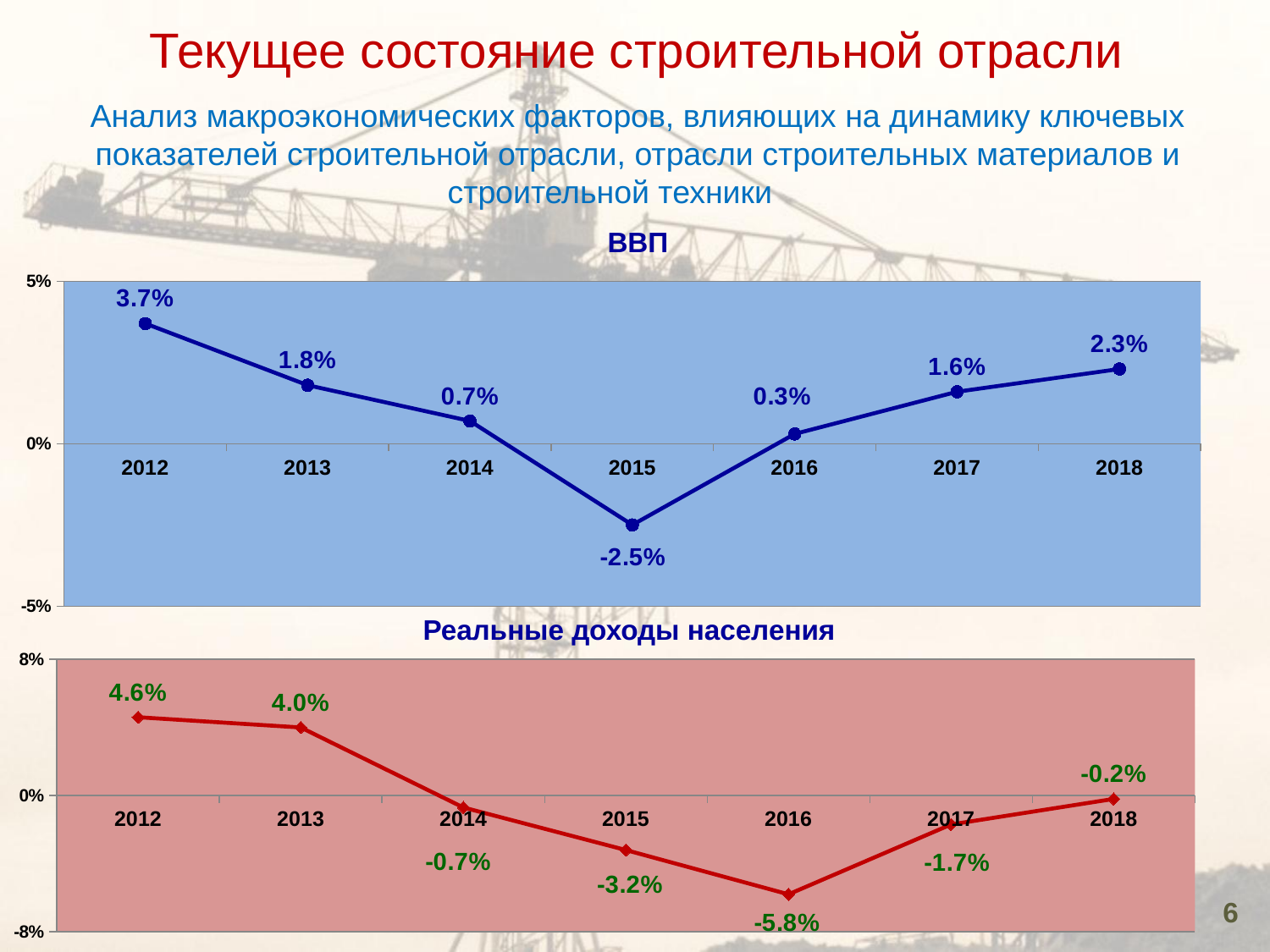
In the ВВП chart, what is the value for 2015? -2.5% In the Реальные доходы населения chart, which year has the highest value? 2012 In the Реальные доходы населения chart, which year has the lowest value? 2016 In the Реальные доходы населения chart, what is the value for 2016? -5.8% In the Реальные доходы населения chart, is the value for 2013 larger or smaller than the value for 2018? larger In the ВВП chart, which year has the highest value? 2012 In the Реальные доходы населения chart, do the values rise or fall from 2012 to 2016? fall In the ВВП chart, what is the difference between the values for 2012 and 2018? 1.4% In the ВВП chart, how many data points are plotted? 7 What kind of chart is the ВВП chart? line chart In the Реальные доходы населения chart, what is the difference between the values for 2012 and 2013? 0.6% In the ВВП chart, which year has the lowest value? 2015